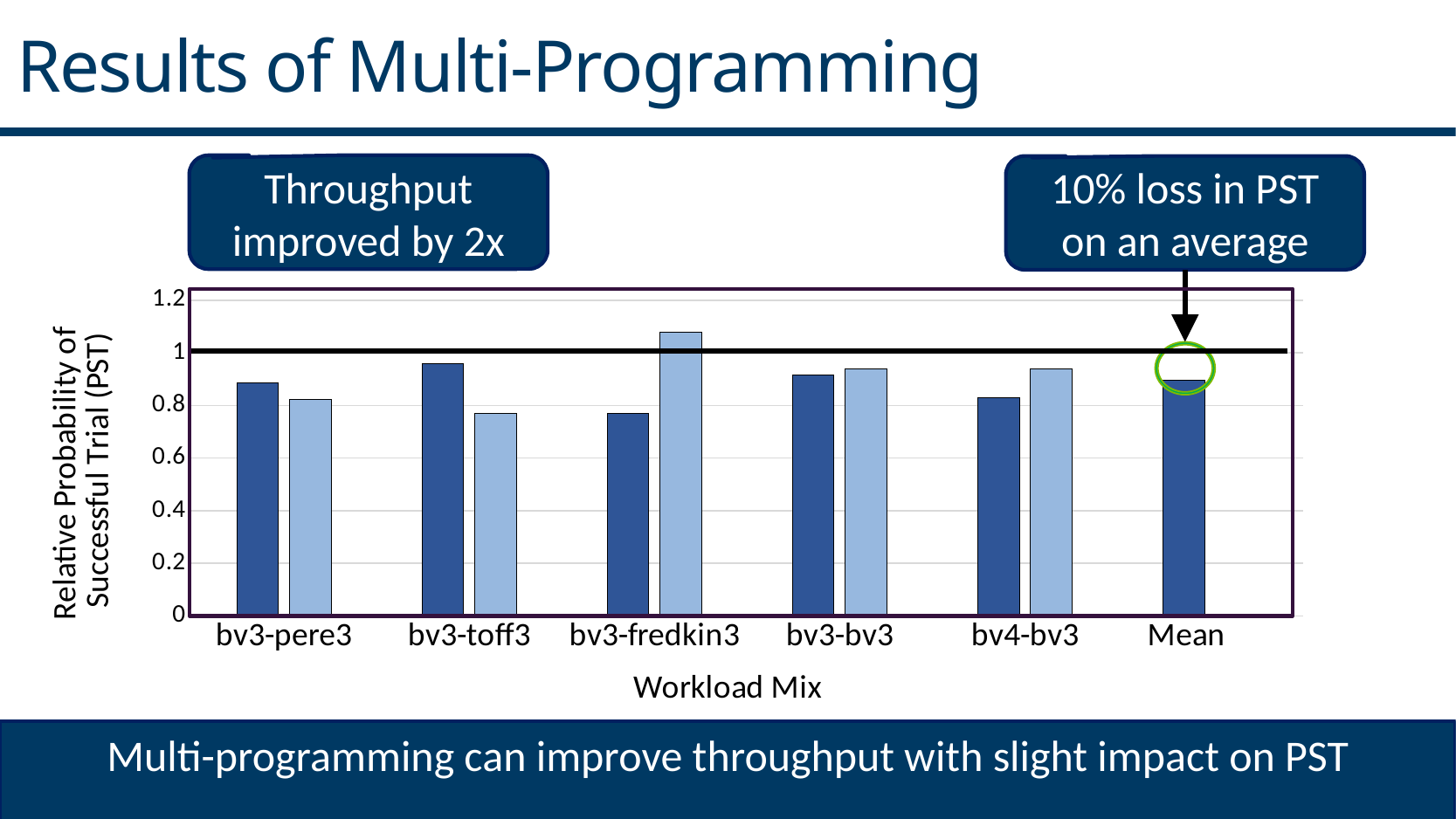
For bv3-fredkin3, which bar is taller, the dark blue or the light blue one? light blue Is the light blue bar for bv3-toff3 greater or less than 0.8? less Which workload mix has the tallest bar in the chart? bv3-fredkin3 What is the title of the x axis? Workload Mix Is the dark blue bar for bv3-toff3 greater or less than 1? less What kind of chart is shown on the slide? bar chart For bv3-toff3, which bar is taller, the dark blue or the light blue one? dark blue For bv4-bv3, which bar is taller, the dark blue or the light blue one? light blue How many workload mix categories are shown on the x axis? 6 Is the dark blue bar for bv3-fredkin3 greater or less than 0.8? less